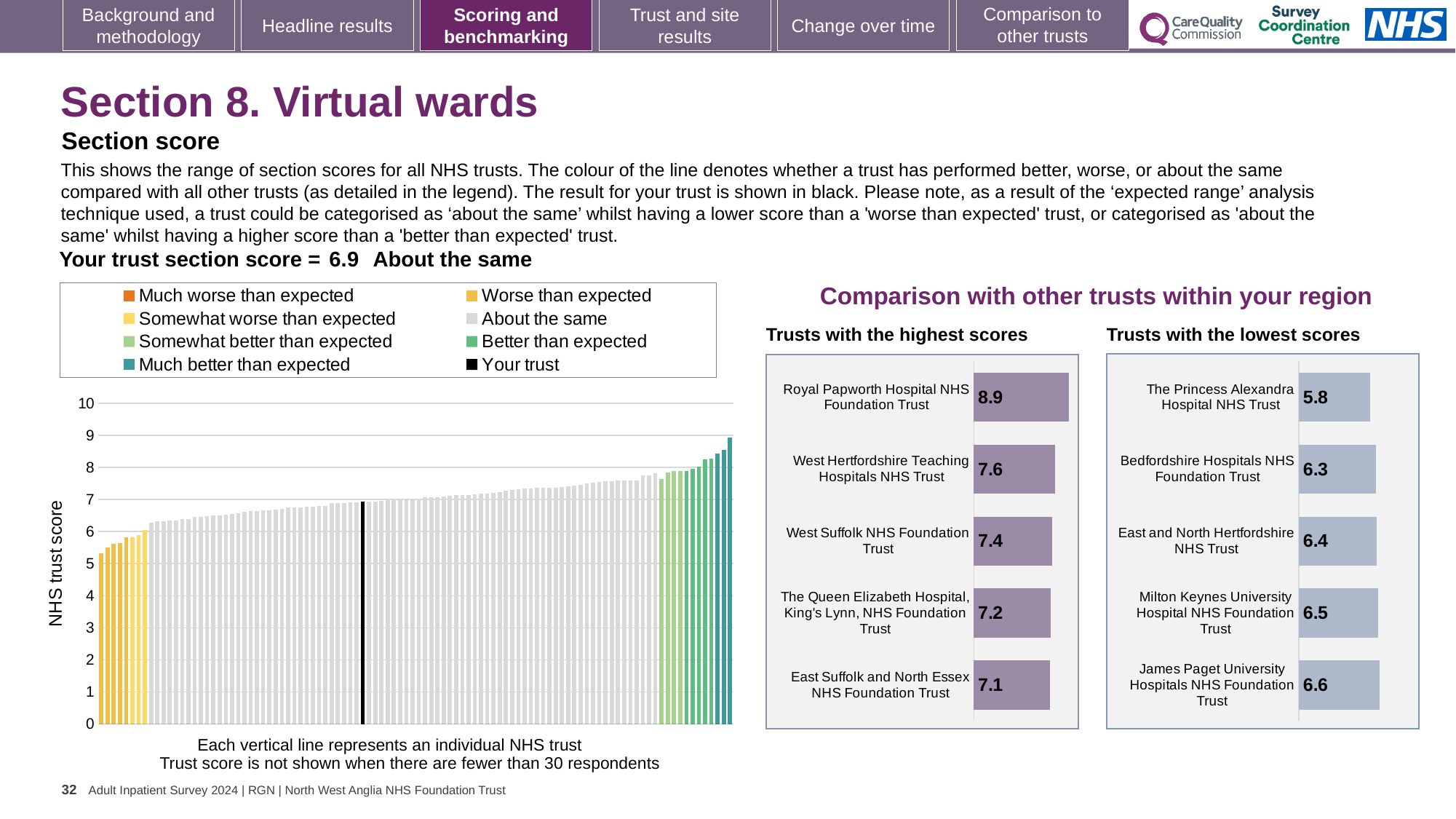
How many entries does the legend of the main NHS trust score chart on the left list? 8 In the 'Trusts with the highest scores' chart, what is the score for Royal Papworth Hospital NHS Foundation Trust? 8.9 In the 'Trusts with the lowest scores' chart, what is the difference between the scores of James Paget University Hospitals NHS Foundation Trust and The Princess Alexandra Hospital NHS Trust? 0.8 In the main NHS trust score chart on the left, what is the section score for your trust (the black line)? 6.9 How many trusts are shown in the 'Trusts with the lowest scores' chart? 5 In the 'Trusts with the highest scores' chart, what is the difference between the scores of Royal Papworth Hospital NHS Foundation Trust and West Hertfordshire Teaching Hospitals NHS Trust? 1.3 In the 'Trusts with the lowest scores' chart, what is the score for The Princess Alexandra Hospital NHS Trust? 5.8 In the main NHS trust score chart on the left, is the value of the tallest bar greater or less than 8? greater In the 'Trusts with the lowest scores' chart, which trust has the lowest score? The Princess Alexandra Hospital NHS Trust What kind of chart is the 'Trusts with the highest scores' chart? Bar chart In the 'Trusts with the highest scores' chart, which has the higher score: West Suffolk NHS Foundation Trust or The Queen Elizabeth Hospital, King's Lynn, NHS Foundation Trust? West Suffolk NHS Foundation Trust In the 'Trusts with the highest scores' chart, which trust has the highest score? Royal Papworth Hospital NHS Foundation Trust